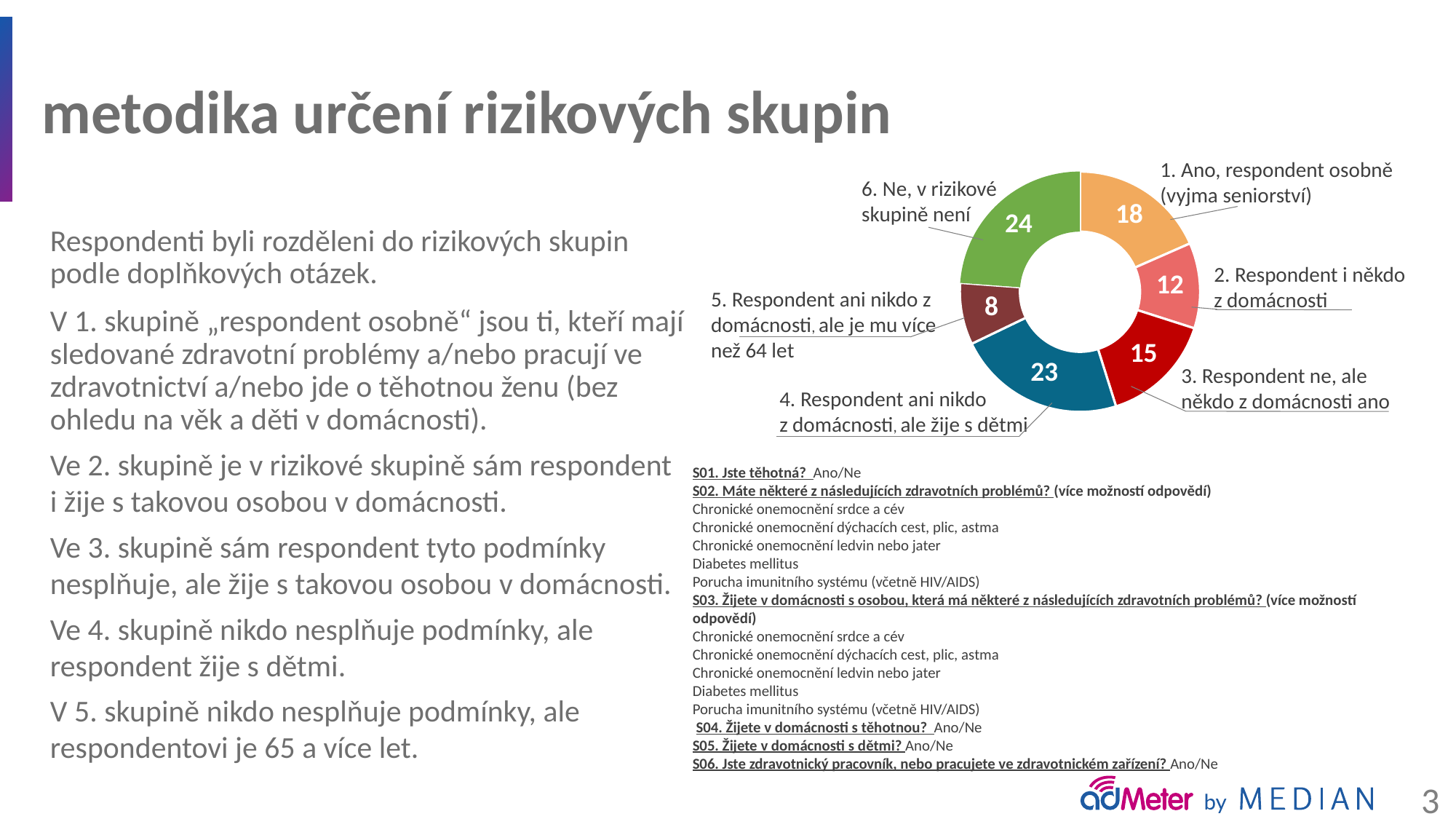
What is the value for segment "1. Ano, respondent osobně (vyjma seniorství)"? 18 How many segments does the doughnut chart have? 6 What is the value for segment "3. Respondent ne, ale někdo z domácnosti ano"? 15 What kind of chart is shown on the slide? Doughnut (pie) chart Which segment has the largest value? 6. Ne, v rizikové skupině není Which is larger: the value for segment 4 (žije s dětmi) or segment 3 (Respondent ne, ale někdo z domácnosti ano)? Segment 4 (žije s dětmi) What is the value for segment "4. Respondent ani nikdo z domácnosti, ale žije s dětmi"? 23 What is the value for segment "2. Respondent i někdo z domácnosti"? 12 What colour is the segment labelled "6. Ne, v rizikové skupině není"? Green Which segment has the smallest value? 5. Respondent ani nikdo z domácnosti, ale je mu více než 64 let What is the value for segment "5. Respondent ani nikdo z domácnosti, ale je mu více než 64 let"? 8 What is the difference between the values of segment 6 (Ne, v rizikové skupině není) and segment 1 (Ano, respondent osobně)? 6